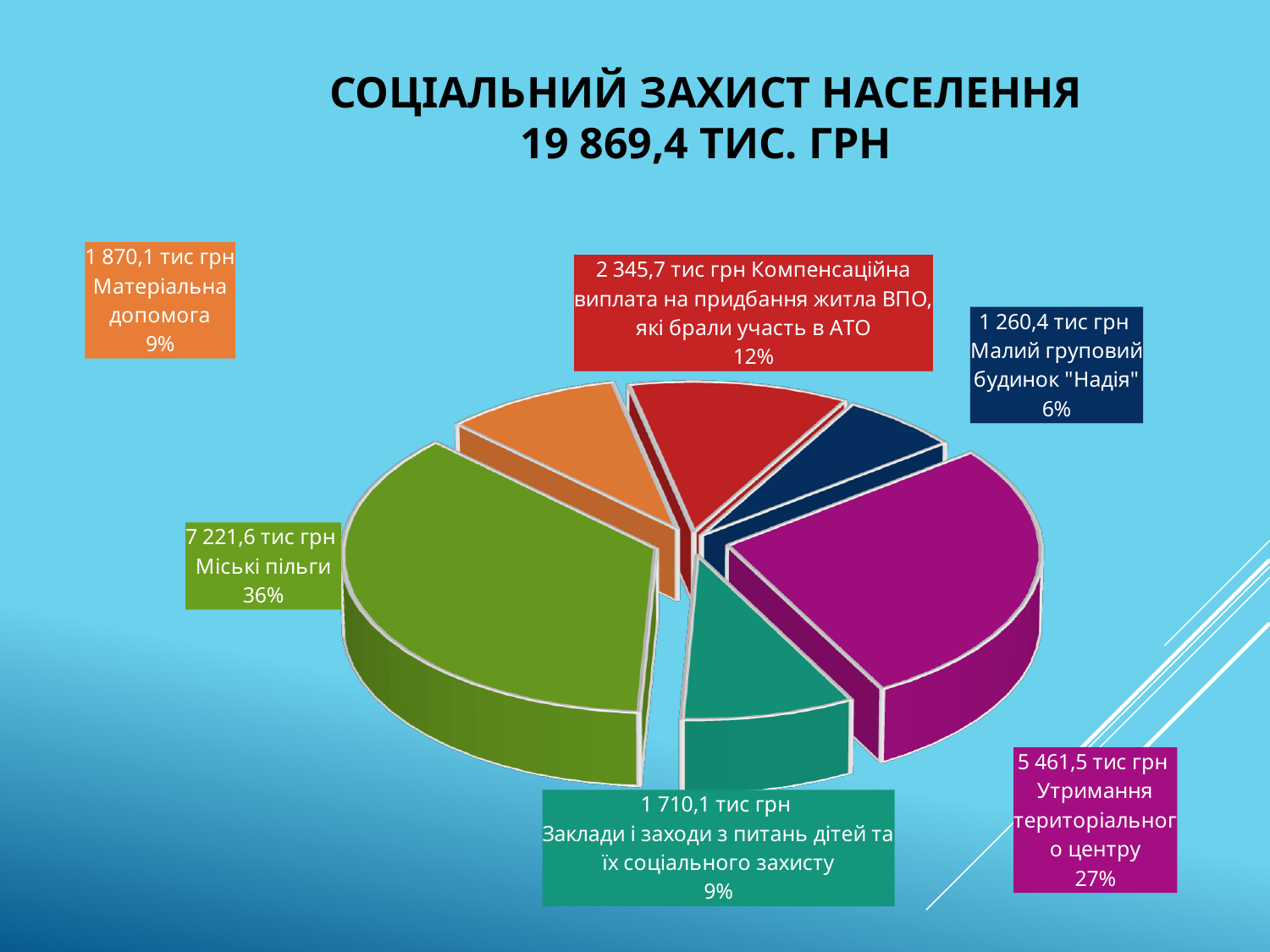
What is the value for Міські пільги? 7 221,6 тис грн Which category has the largest slice of the pie? Міські пільги How many slices does the pie chart have? 6 What is the value for Малий груповий будинок "Надія"? 1 260,4 тис грн Which is larger: the value for Матеріальна допомога or the value for Компенсаційна виплата на придбання житла ВПО, які брали участь в АТО? Компенсаційна виплата на придбання житла ВПО, які брали участь в АТО What is the difference between the values for Міські пільги and Утримання територіального центру? 1 760,1 тис грн What kind of chart is shown on the slide? pie chart What share of the pie does Заклади і заходи з питань дітей та їх соціального захисту represent? 9% What colour is the slice for Міські пільги? green What share of the pie does Утримання територіального центру represent? 27% Which category has the smallest slice of the pie? Малий груповий будинок "Надія" What total amount is stated in the chart title? 19 869,4 тис. грн